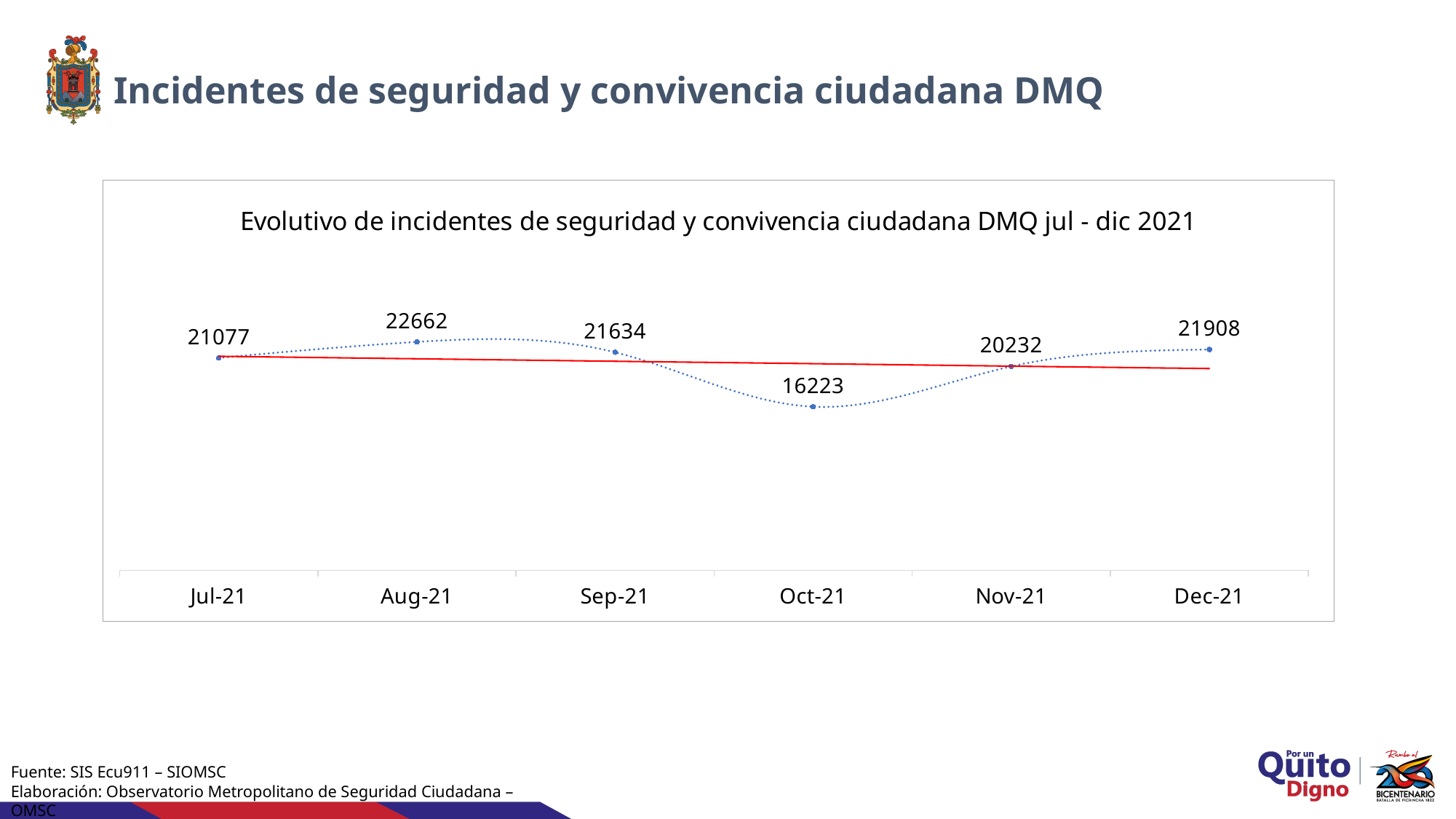
Which month has the lowest value? Oct-21 Does the value rise or fall from Sep-21 to Oct-21? fall What is the value for Aug-21? 22662 What kind of chart is this? line chart Which is larger, the value for Jul-21 or the value for Sep-21? Sep-21 What is the difference between the values for Dec-21 and Nov-21? 1676 Which month has the highest value? Aug-21 What is the value for Oct-21? 16223 What is the difference between the values for Aug-21 and Oct-21? 6439 What is the value for Dec-21? 21908 How many months are plotted on the chart? 6 What is the title of the chart? Evolutivo de incidentes de seguridad y convivencia ciudadana DMQ jul - dic 2021